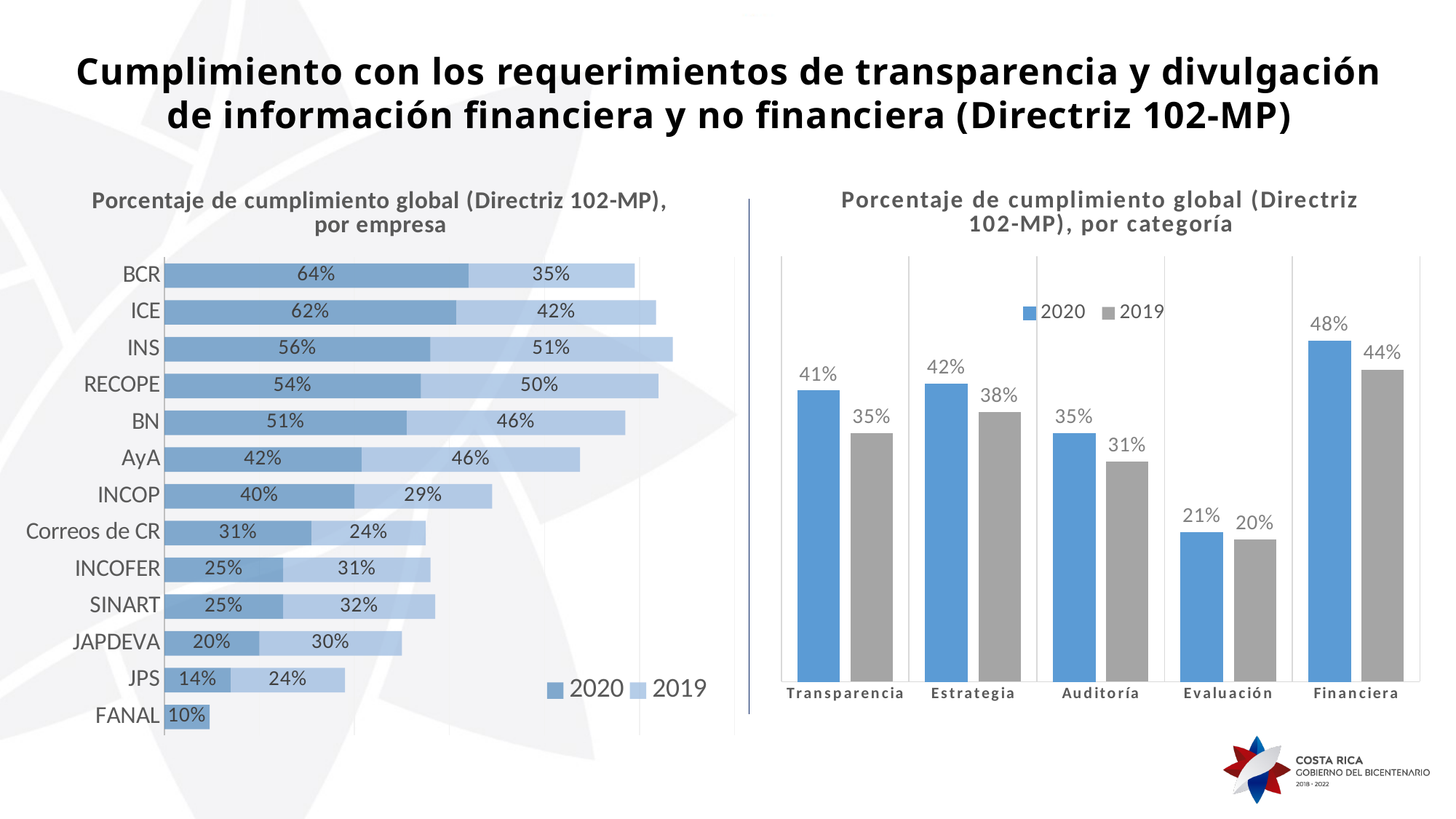
In the chart 'Porcentaje de cumplimiento global (Directriz 102-MP), por categoría', what is the 2019 value for Auditoría? 31% In the chart 'Porcentaje de cumplimiento global (Directriz 102-MP), por empresa', what is the difference between the 2020 and 2019 values for ICE? 20% In the chart 'Porcentaje de cumplimiento global (Directriz 102-MP), por empresa', what is the 2019 value for INCOP? 29% In the chart 'Porcentaje de cumplimiento global (Directriz 102-MP), por empresa', how many companies are listed? 13 In the chart 'Porcentaje de cumplimiento global (Directriz 102-MP), por empresa', which company has the lowest 2020 value? FANAL In the chart 'Porcentaje de cumplimiento global (Directriz 102-MP), por categoría', which category has the lowest 2020 value? Evaluación In the chart 'Porcentaje de cumplimiento global (Directriz 102-MP), por empresa', which company has the highest 2020 value? BCR In the chart 'Porcentaje de cumplimiento global (Directriz 102-MP), por empresa', which is larger for JAPDEVA, the 2020 value or the 2019 value? 2019 In the chart 'Porcentaje de cumplimiento global (Directriz 102-MP), por categoría', how many series does the legend list? 2 In the chart 'Porcentaje de cumplimiento global (Directriz 102-MP), por empresa', what is the 2020 value for BCR? 64% In the chart 'Porcentaje de cumplimiento global (Directriz 102-MP), por categoría', what is the 2020 value for Financiera? 48% What kind of chart is 'Porcentaje de cumplimiento global (Directriz 102-MP), por categoría'? Bar chart